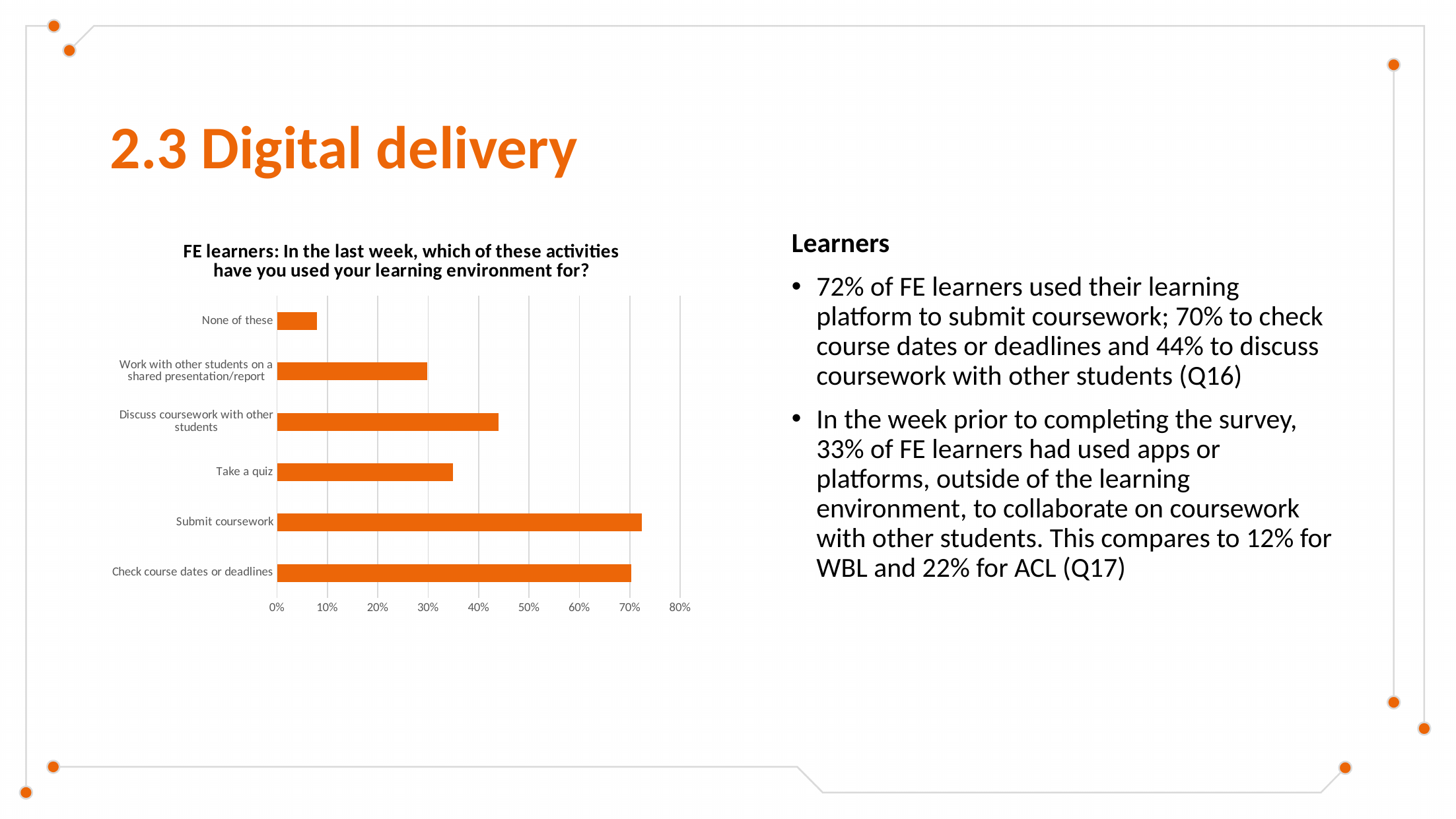
Which is larger: the value for 'Submit coursework' or the value for 'Take a quiz'? Submit coursework Is the value for 'None of these' greater or less than 10%? less Is the value for 'Submit coursework' greater or less than 60%? greater Is the value for 'Discuss coursework with other students' greater or less than 40%? greater Which category has the lowest value in the chart? None of these What kind of chart is shown on the slide? bar chart Which is larger: the value for 'Discuss coursework with other students' or the value for 'Take a quiz'? Discuss coursework with other students How many activity categories are plotted in the chart? 6 What colour are the bars in the chart? orange